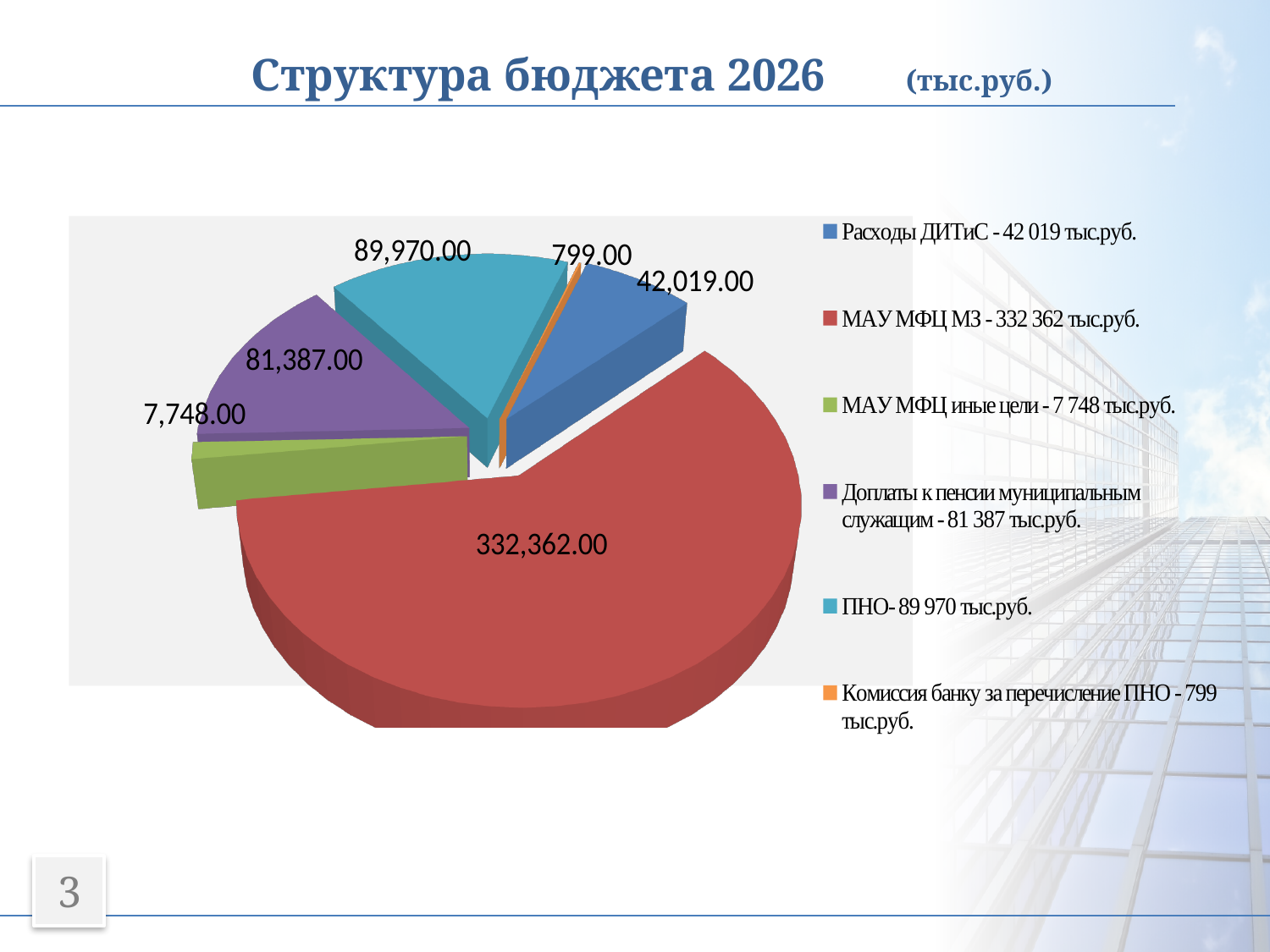
Which is larger: the slice for ПНО or the slice for Доплаты к пенсии муниципальным служащим? ПНО What is the value of the slice for ПНО? 89,970.00 What type of chart is shown on the slide? Pie chart What is the difference between the ПНО slice and the Доплаты к пенсии муниципальным служащим slice? 8,583.00 How many slices does the pie chart have? 6 Which category has the largest slice of the pie? МАУ МФЦ МЗ What colour is the slice for МАУ МФЦ иные цели? Green What is the difference between the Расходы ДИТиС slice and the МАУ МФЦ иные цели slice? 34,271.00 What is the value of the slice for МАУ МФЦ МЗ? 332,362.00 Which category has the smallest slice of the pie? Комиссия банку за перечисление ПНО What is the value of the slice for Комиссия банку за перечисление ПНО? 799.00 What is the value of the slice for Расходы ДИТиС? 42,019.00